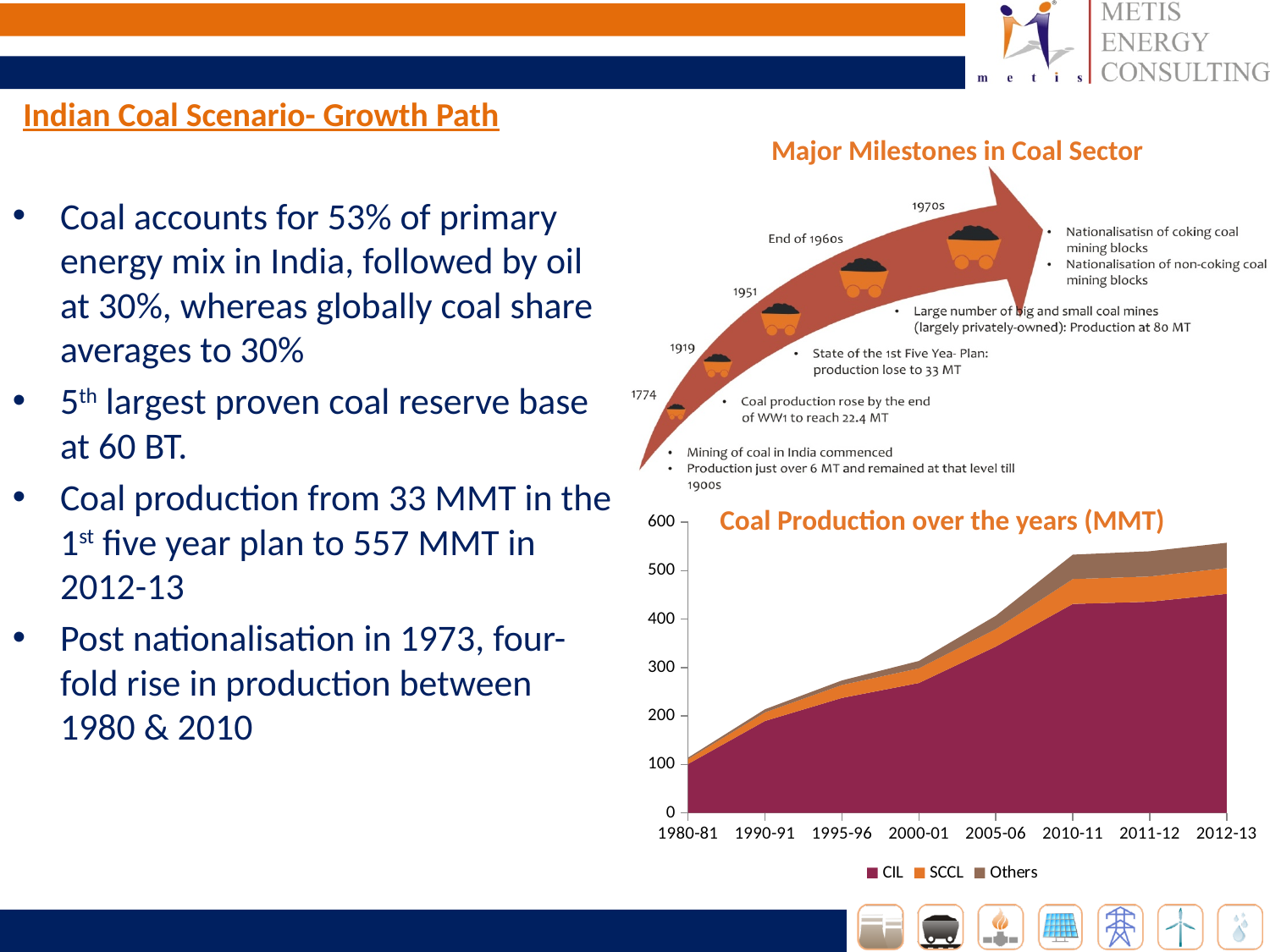
In the 'Coal Production over the years (MMT)' chart, does total coal production rise or fall from 1980-81 to 2012-13? rise How many year categories are shown on the x axis of the 'Coal Production over the years (MMT)' chart? 8 In the 'Coal Production over the years (MMT)' chart, which is larger: total production in 2010-11 or in 1995-96? 2010-11 In the 'Coal Production over the years (MMT)' chart, is the CIL value for 2005-06 greater or less than 300? greater In the 'Coal Production over the years (MMT)' chart, is the total production for 2012-13 greater or less than 500? greater How many series does the legend of the 'Coal Production over the years (MMT)' chart list? 3 In the 'Coal Production over the years (MMT)' chart, is the CIL value for 2000-01 greater or less than 300? less In the 'Coal Production over the years (MMT)' chart, which year has the highest total coal production? 2012-13 Which series are listed in the legend of the 'Coal Production over the years (MMT)' chart? CIL, SCCL, Others What kind of chart is 'Coal Production over the years (MMT)'? area chart In the 'Coal Production over the years (MMT)' chart, which year has the lowest total coal production? 1980-81